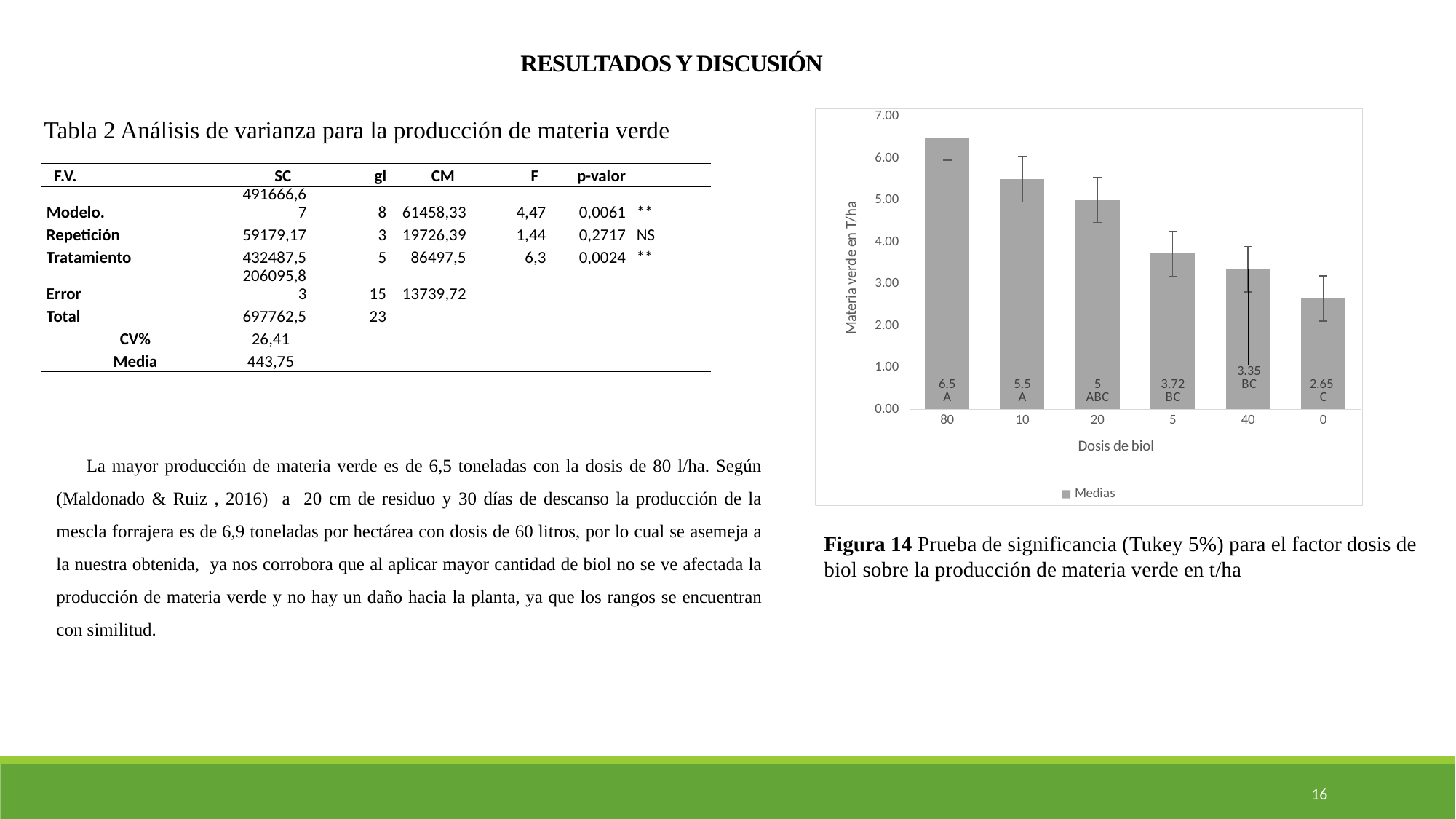
What is the label of the y axis? Materia verde en T/ha Which biol dose has the lowest value? 0 Is the value for dose 5 greater or less than 4.00? less Which is larger, the value for dose 10 or the value for dose 20? 10 What is the value for the biol dose of 80? 6.5 What type of chart is shown on the slide? bar chart What is the difference between the values for doses 80 and 0? 3.85 How many biol doses are plotted on the x axis? 6 How many series does the legend list? 1 What is the value for the biol dose of 0? 2.65 What is the value for the biol dose of 40? 3.35 Which biol dose has the highest value? 80